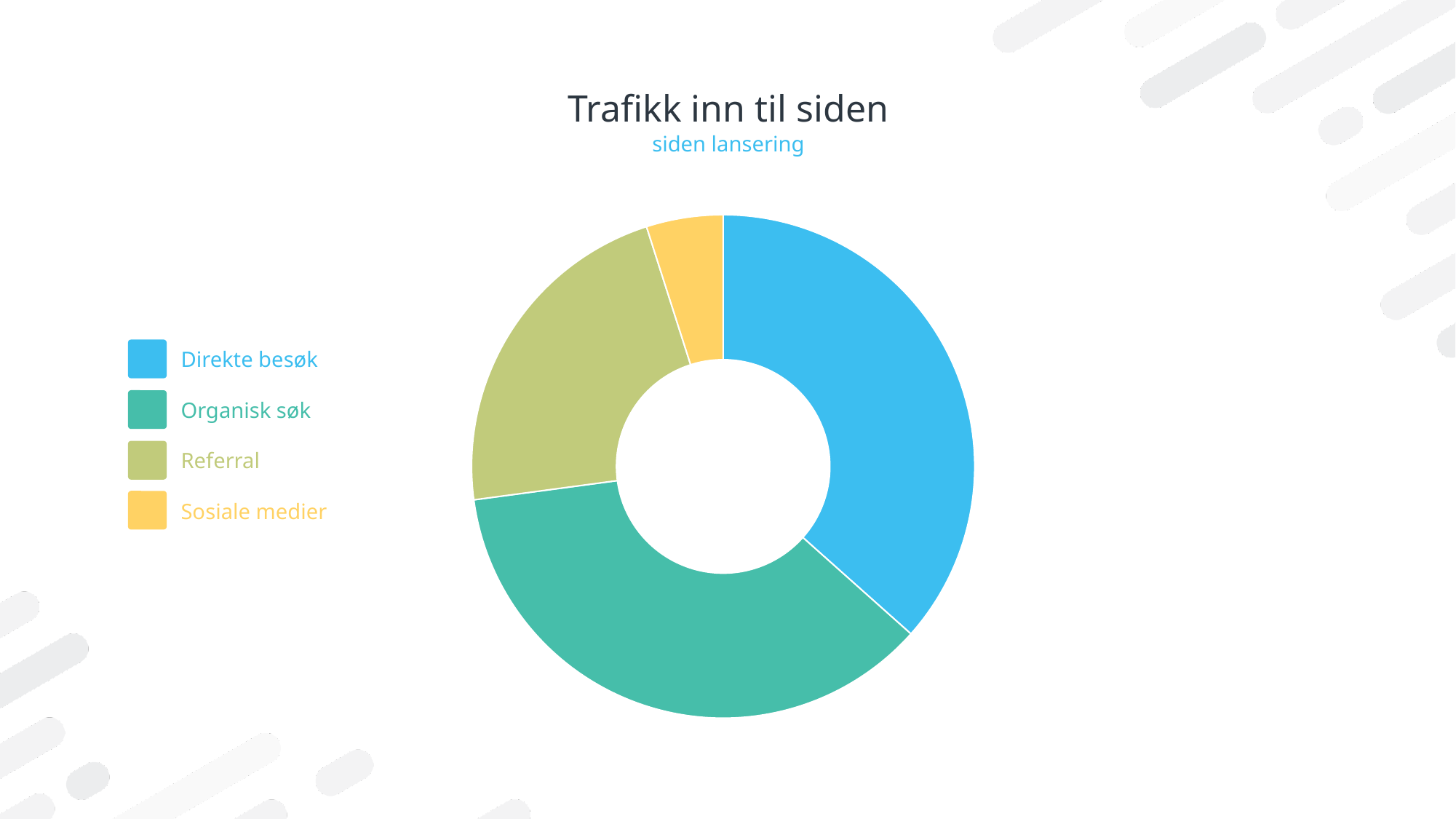
What kind of chart is shown on the slide? Pie chart (donut) Which slice is larger: Referral or Sosiale medier? Referral Which slice is larger: Organisk søk or Sosiale medier? Organisk søk Which category has the smallest slice in the pie chart? Sosiale medier What colour represents Organisk søk in the chart? Teal (green) Which slice is larger: Direkte besøk or Referral? Direkte besøk How many categories does the pie chart show? 4 How many entries does the legend list? 4 What is the title of the chart? Trafikk inn til siden